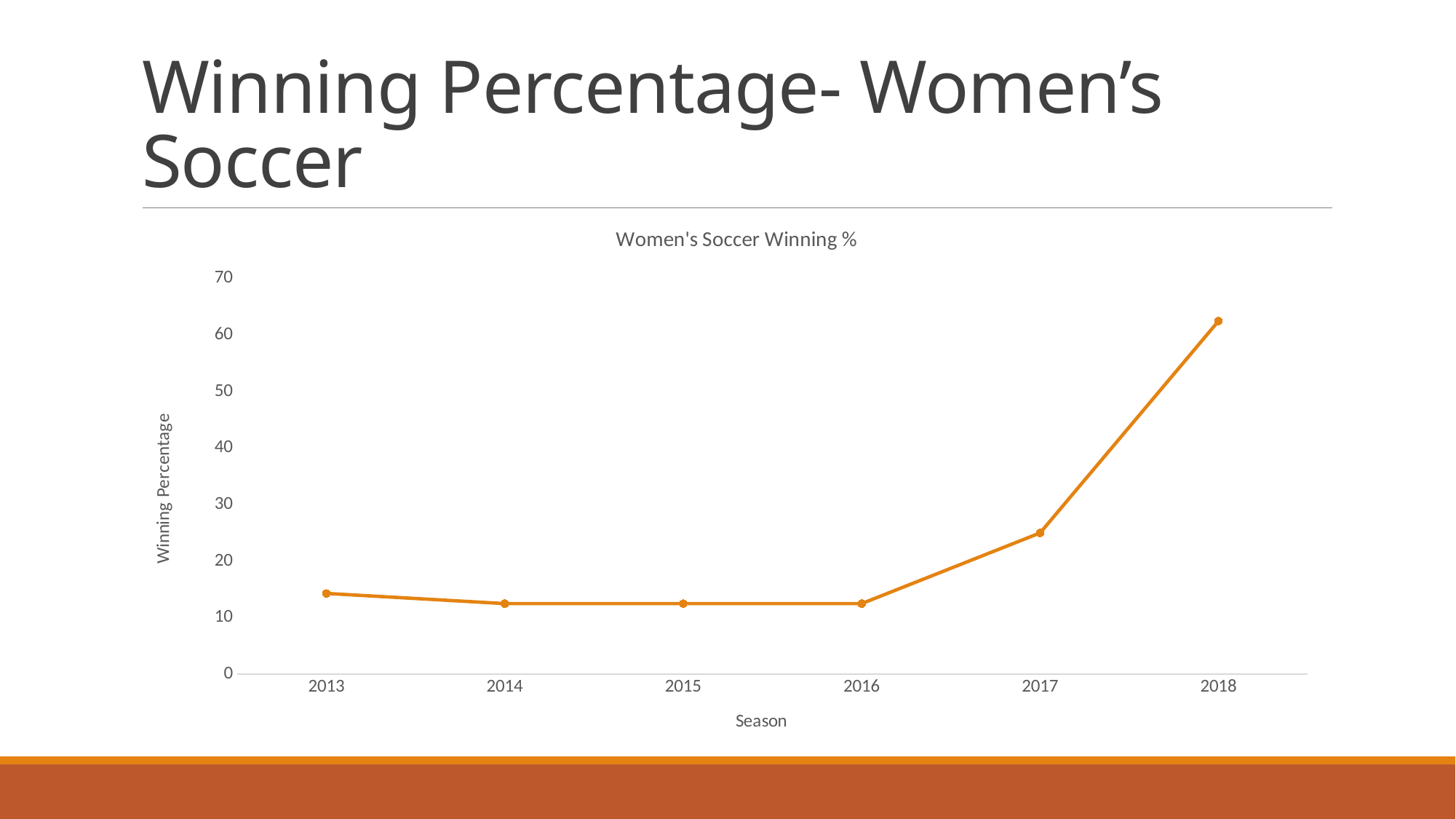
Is the winning percentage for 2016 greater or less than 10? greater Is the winning percentage for 2017 greater or less than 30? less Which season has the highest winning percentage? 2018 How many seasons are plotted on the chart? 6 Does the winning percentage rise or fall from 2016 to 2018? rise What is the title of the chart? Women's Soccer Winning % Is the winning percentage for 2013 greater or less than 20? less Which season has the larger winning percentage, 2017 or 2018? 2018 Which season has the larger winning percentage, 2015 or 2017? 2017 What is the label on the x axis of the chart? Season What kind of chart is shown on the slide? line chart